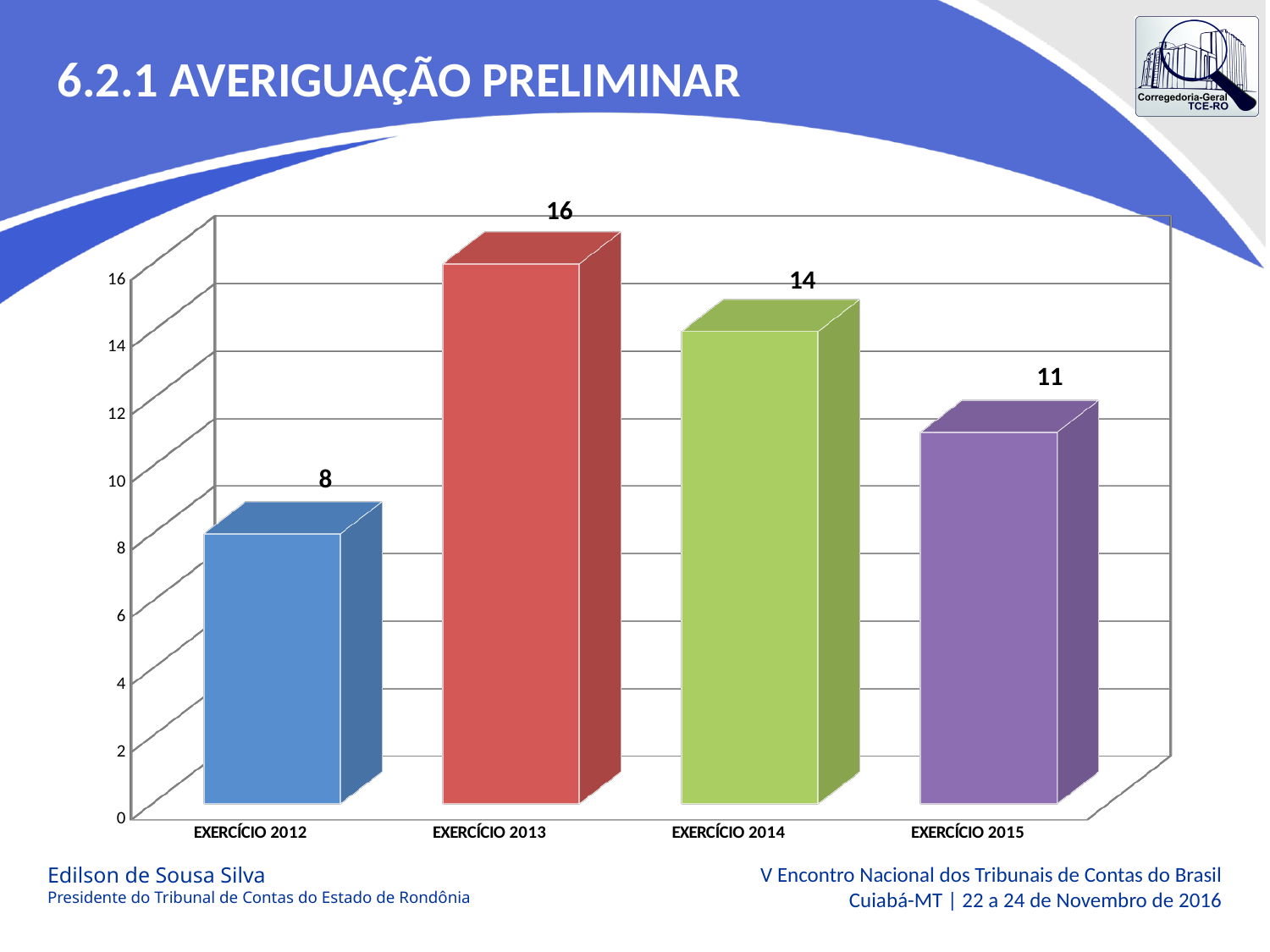
How many categories are shown on the x axis? 4 What is the value for EXERCÍCIO 2014? 14 What is the difference between the values for EXERCÍCIO 2014 and EXERCÍCIO 2015? 3 What is the difference between the values for EXERCÍCIO 2013 and EXERCÍCIO 2012? 8 What is the value for EXERCÍCIO 2015? 11 Which category has the highest value? EXERCÍCIO 2013 What is the title of the slide containing the chart? 6.2.1 AVERIGUAÇÃO PRELIMINAR Which is larger, the value for EXERCÍCIO 2014 or EXERCÍCIO 2015? EXERCÍCIO 2014 Which category has the lowest value? EXERCÍCIO 2012 What is the value for EXERCÍCIO 2012? 8 What kind of chart is shown on the slide? Bar chart What is the value for EXERCÍCIO 2013? 16